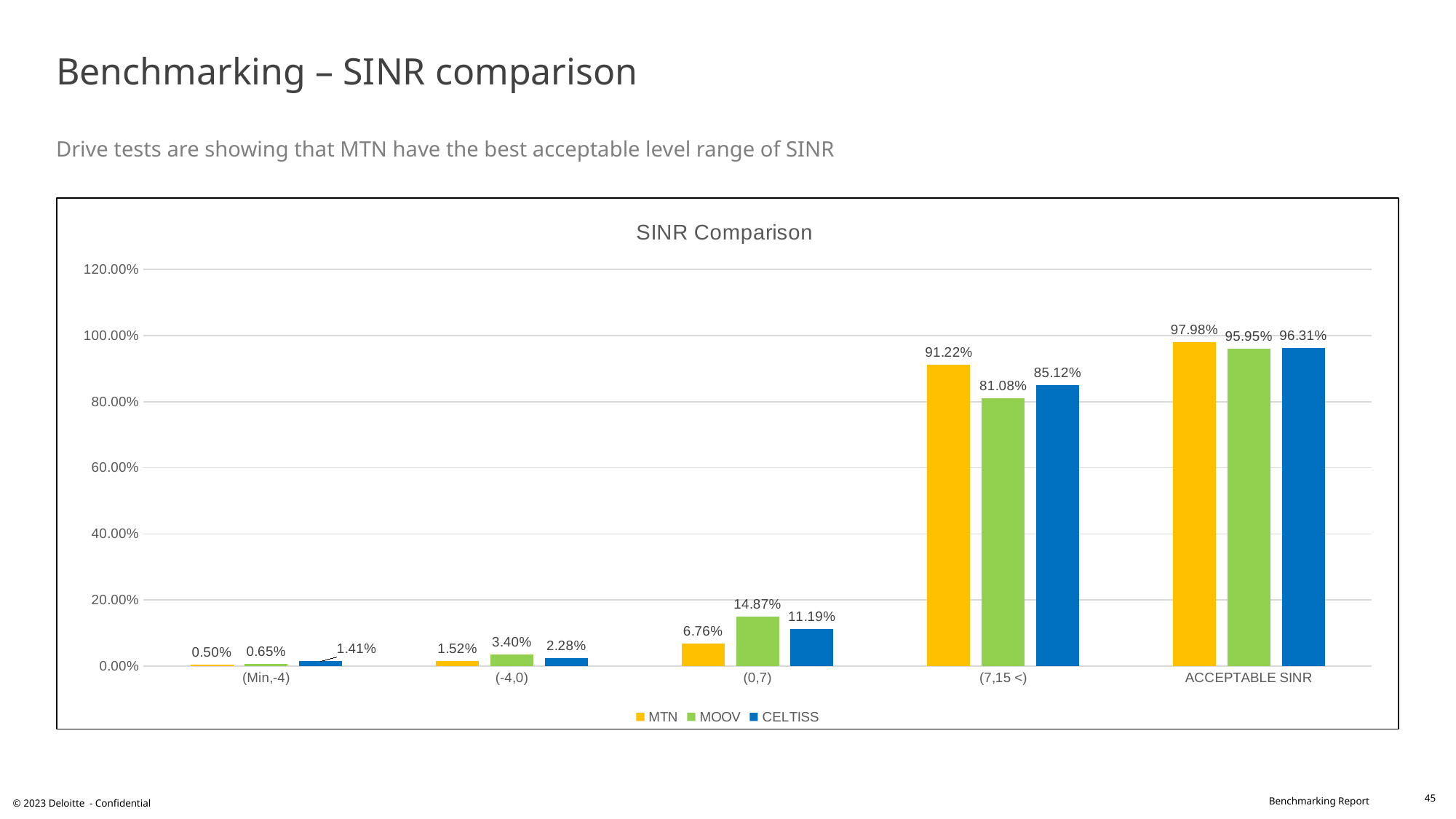
How many series does the legend list? 3 How many categories are shown on the x axis? 5 Is the value for CELTISS in the (7,15 <) category greater or less than 80.00%? greater What is the difference between MTN and MOOV in the (7,15 <) category? 10.14% What is the value for CELTISS in the (0,7) category? 11.19% What is the value for MTN in the (7,15 <) category? 91.22% What kind of chart is shown on the slide? Bar chart Which is larger in the (0,7) category, MOOV or CELTISS? MOOV What is the title of the chart? SINR Comparison What is the value for MOOV in the ACCEPTABLE SINR category? 95.95% Which operator has the highest value in the ACCEPTABLE SINR category? MTN Which operator has the lowest value in the (Min,-4) category? MTN